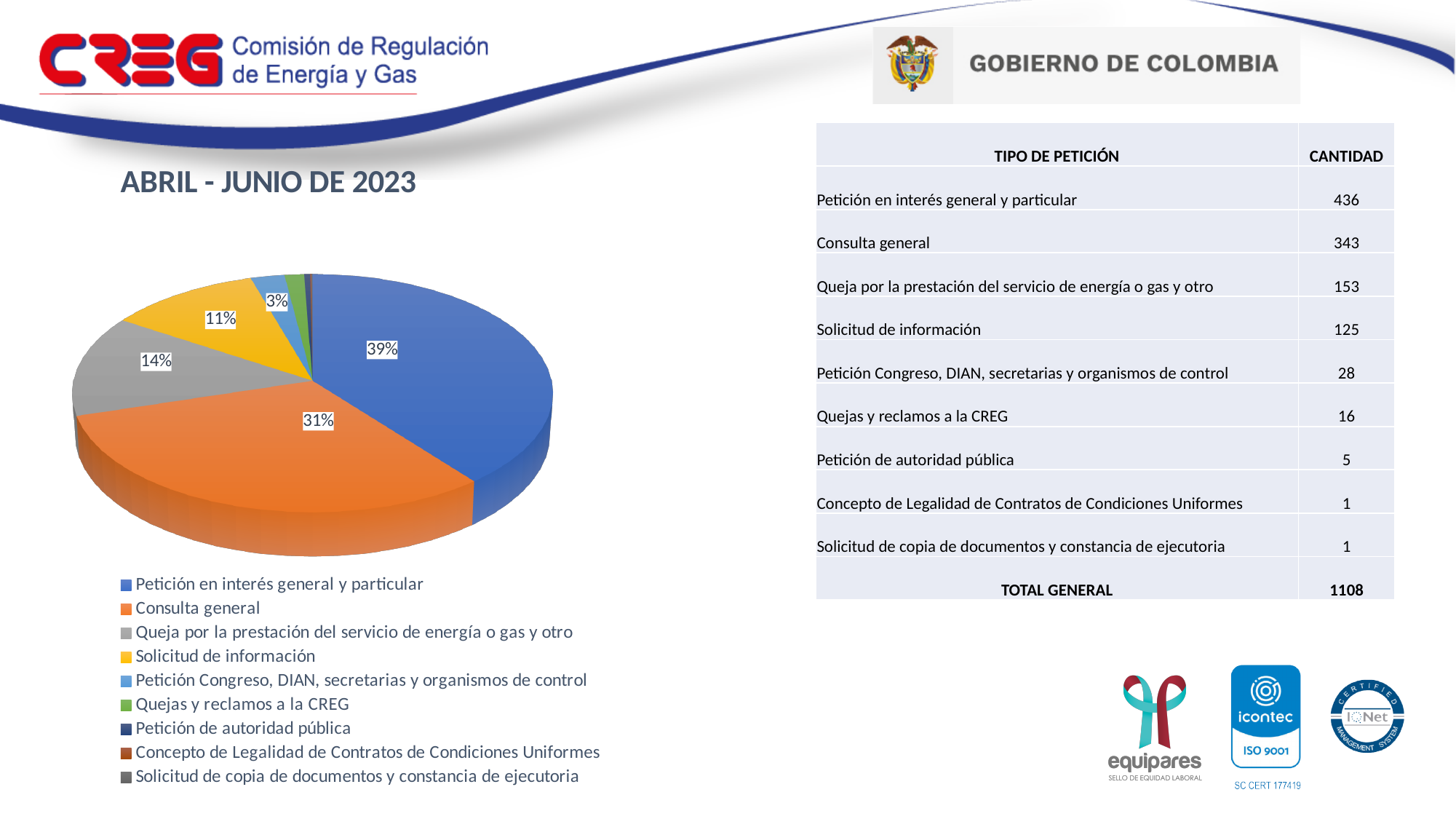
What share of the pie does 'Consulta general' represent? 31% What share of the pie does 'Solicitud de información' represent? 11% What share of the pie does 'Petición en interés general y particular' represent? 39% Which category has the largest slice of the pie? Petición en interés general y particular What is the difference in percentage points between the 'Petición en interés general y particular' slice and the 'Consulta general' slice? 8 percentage points What kind of chart is shown on the slide? pie chart How many categories are listed in the pie chart's legend? 9 Which slice is larger: 'Consulta general' or 'Queja por la prestación del servicio de energía o gas y otro'? Consulta general What is the title shown above the pie chart? ABRIL - JUNIO DE 2023 What colour is the 'Consulta general' slice in the pie chart? orange